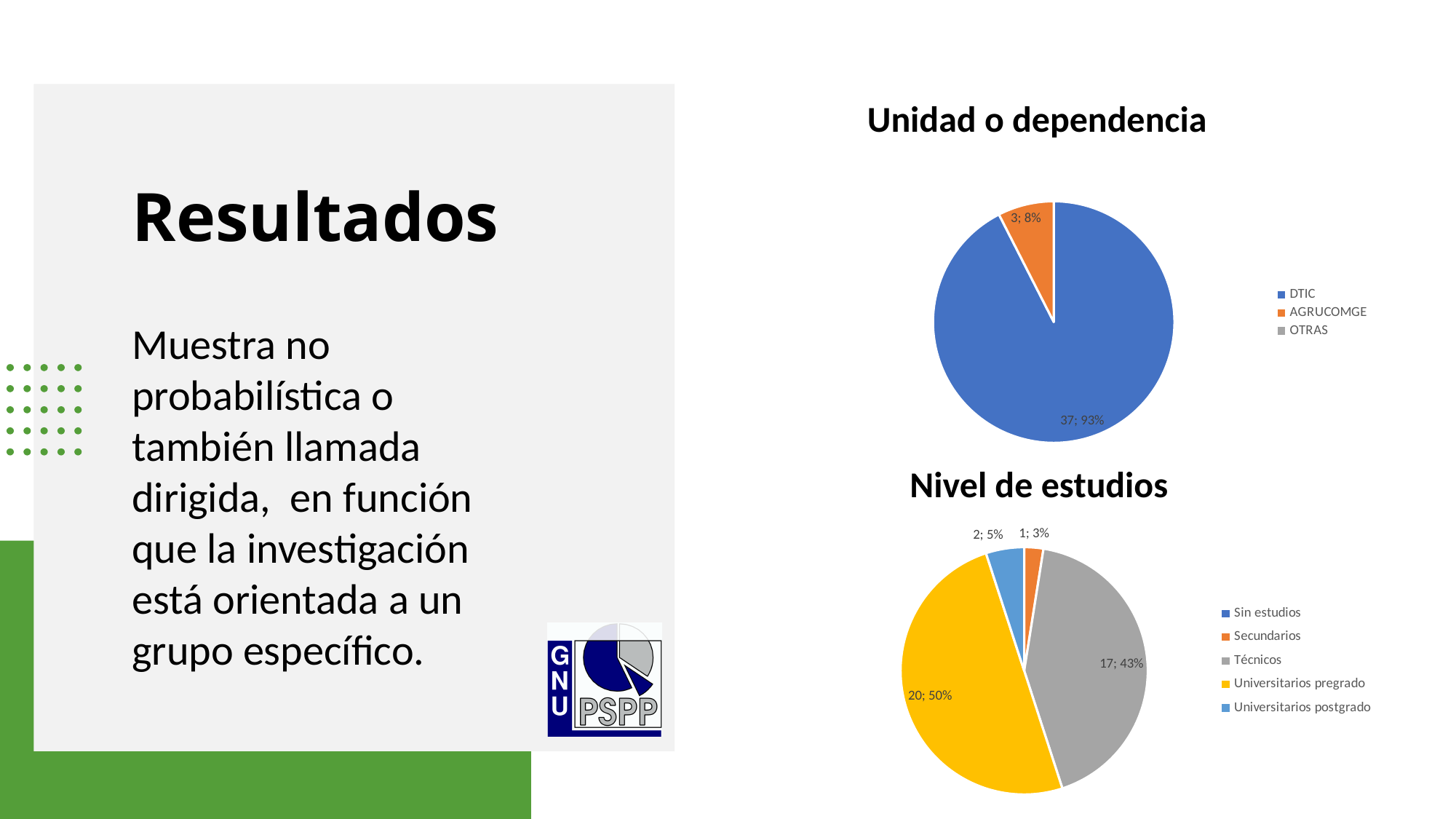
In the 'Nivel de estudios' chart, what colour is the Técnicos slice? gray In the 'Unidad o dependencia' chart, which category has the largest slice? DTIC In the 'Unidad o dependencia' chart, what is the count for AGRUCOMGE? 3 In the 'Nivel de estudios' chart, which category has the largest slice? Universitarios pregrado In the 'Nivel de estudios' chart, how many entries does the legend list? 5 In the 'Nivel de estudios' chart, what is the count for Técnicos? 17 In the 'Unidad o dependencia' chart, what share of the pie does DTIC have? 93% In the 'Nivel de estudios' chart, which is larger, Universitarios postgrado or Secundarios? Universitarios postgrado In the 'Unidad o dependencia' chart, what kind of chart is shown? pie chart In the 'Nivel de estudios' chart, what share of the pie does Universitarios pregrado have? 50% In the 'Unidad o dependencia' chart, what is the difference between the DTIC count and the AGRUCOMGE count? 34 In the 'Unidad o dependencia' chart, how many entries does the legend list? 3